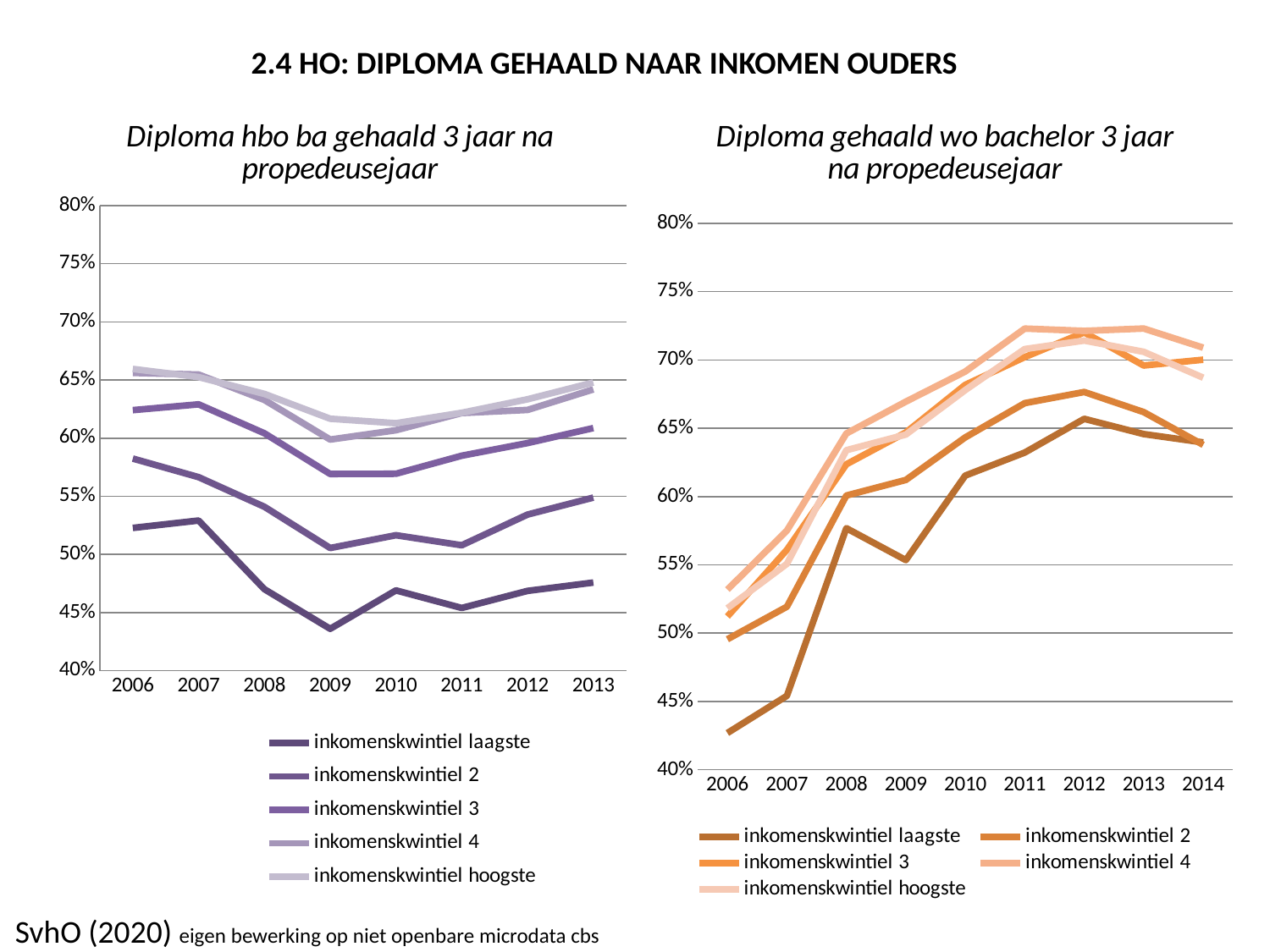
In the left chart, 'Diploma hbo ba gehaald 3 jaar na propedeusejaar', does the inkomenskwintiel laagste line rise or fall from 2006 to 2009? fall In the right chart, 'Diploma gehaald wo bachelor 3 jaar na propedeusejaar', is the value for inkomenskwintiel 4 in 2011 greater or less than 70%? greater How many series does the legend of the right chart, 'Diploma gehaald wo bachelor 3 jaar na propedeusejaar', list? 5 In the left chart, 'Diploma hbo ba gehaald 3 jaar na propedeusejaar', which is larger in 2013: inkomenskwintiel hoogste or inkomenskwintiel laagste? inkomenskwintiel hoogste In the right chart, 'Diploma gehaald wo bachelor 3 jaar na propedeusejaar', does the inkomenskwintiel laagste line rise or fall from 2006 to 2012? rise What kind of chart is the left chart, 'Diploma hbo ba gehaald 3 jaar na propedeusejaar'? line chart In the left chart, 'Diploma hbo ba gehaald 3 jaar na propedeusejaar', is the value for inkomenskwintiel 3 in 2009 greater or less than 55%? greater In the left chart, 'Diploma hbo ba gehaald 3 jaar na propedeusejaar', in which year is the inkomenskwintiel laagste line at its lowest? 2009 How many years are shown on the x axis of the left chart, 'Diploma hbo ba gehaald 3 jaar na propedeusejaar'? 8 How many years are shown on the x axis of the right chart, 'Diploma gehaald wo bachelor 3 jaar na propedeusejaar'? 9 In the left chart, 'Diploma hbo ba gehaald 3 jaar na propedeusejaar', is the value for inkomenskwintiel laagste in 2009 greater or less than 45%? less